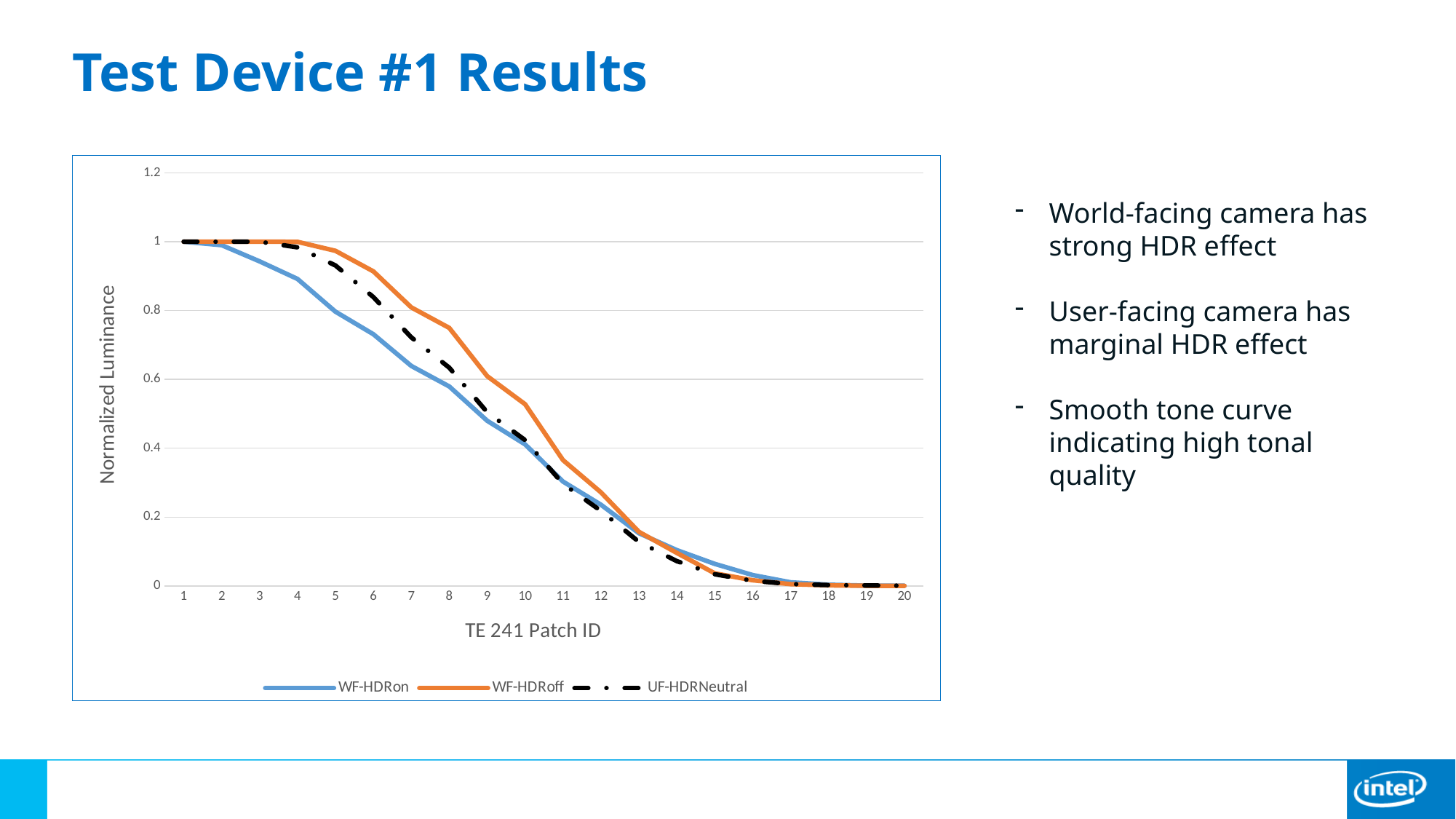
How many series does the chart legend list? 3 What kind of chart is shown on the slide? line chart Is the value for UF-HDRNeutral at patch ID 13 greater or less than 0.2? less What is the normalized luminance of WF-HDRoff at patch ID 1? 1 Do the values of the WF-HDRon series rise or fall as the TE 241 Patch ID increases? fall Is the value for WF-HDRon at patch ID 4 greater or less than 0.8? greater At patch ID 5, which series has the higher normalized luminance, WF-HDRon or UF-HDRNeutral? UF-HDRNeutral What is the title of the chart's x axis? TE 241 Patch ID How many patch IDs are plotted along the x axis? 20 At patch ID 9, which series has the higher normalized luminance, WF-HDRon or WF-HDRoff? WF-HDRoff Is the value for WF-HDRoff at patch ID 8 greater or less than 0.8? less